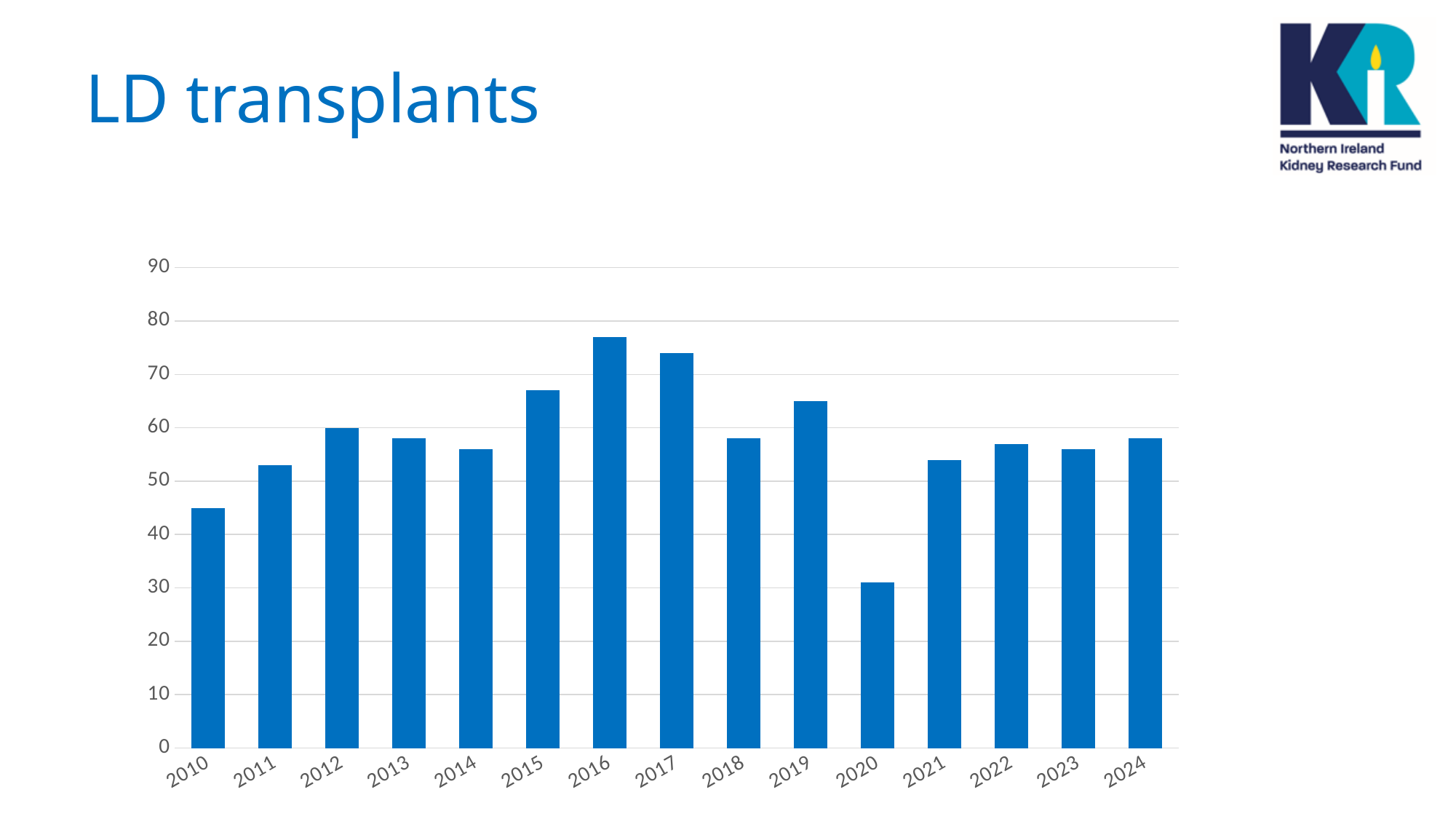
What is the title of the slide containing the chart? LD transplants Which year has the larger value, 2019 or 2021? 2019 Is the value for 2010 greater or less than 50? less Which year has the highest number of LD transplants? 2016 How many years are plotted on the x axis of the chart? 15 Is the value for 2020 greater or less than 40? less Is the value for 2016 greater or less than 70? greater Which year has the lowest number of LD transplants? 2020 Which year has the larger value, 2010 or 2015? 2015 What kind of chart is shown on the slide? bar chart